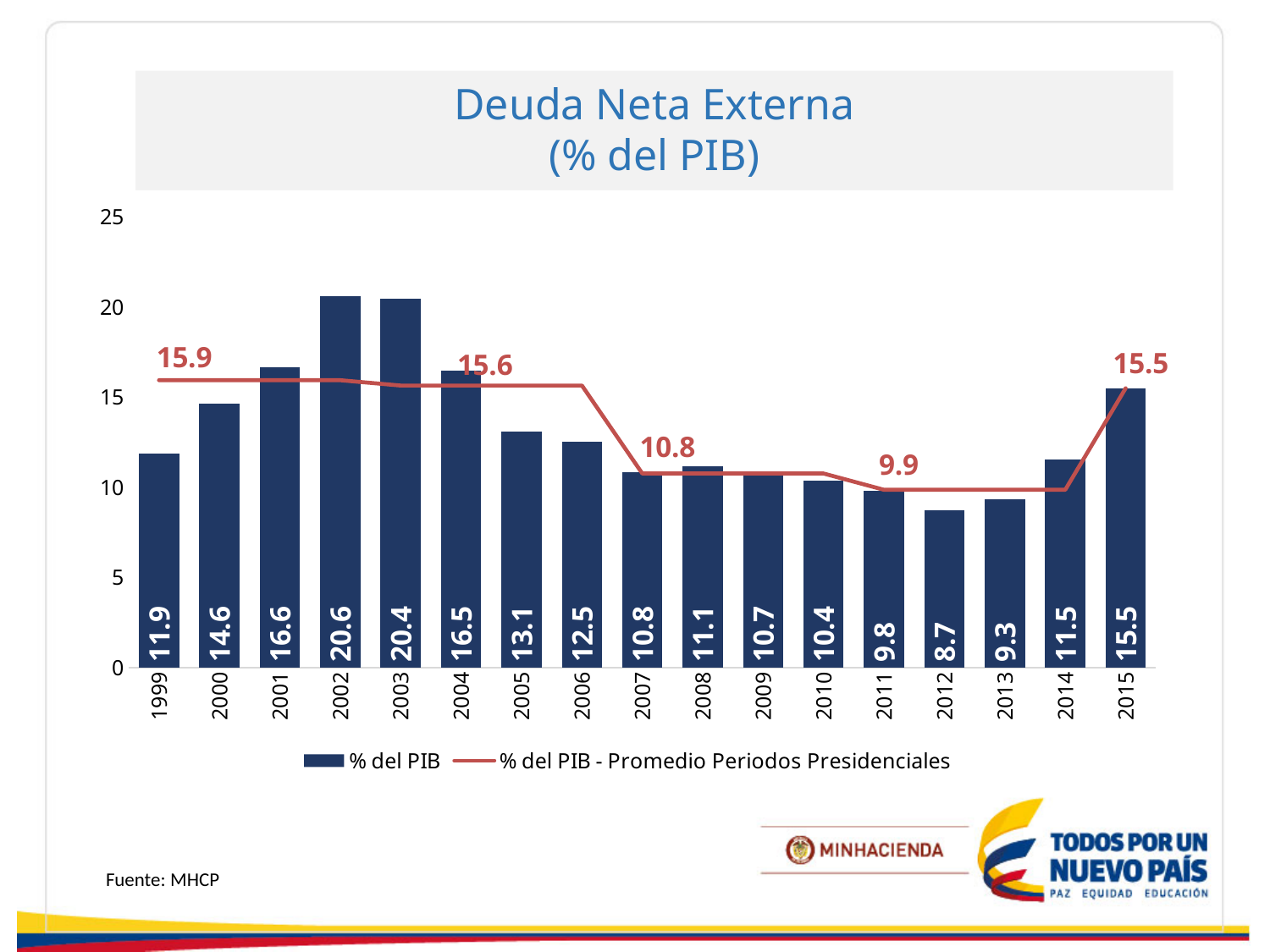
Do the % del PIB bars rise or fall from 2003 to 2012? fall How many series does the legend list? 2 What is the value of the % del PIB - Promedio Periodos Presidenciales line labelled over the 2007 period? 10.8 What kind of chart is used for the % del PIB series? bar chart Which year has the lowest % del PIB bar? 2012 What is the title of the chart? Deuda Neta Externa (% del PIB) How many years are shown on the x axis? 17 Which year has the highest % del PIB bar? 2002 Which is larger, the % del PIB value for 2000 or for 2005? 2000 What is the difference between the % del PIB values for 2015 and 2014? 4.0 What is the value of % del PIB for 2002? 20.6 What is the value of % del PIB for 2012? 8.7